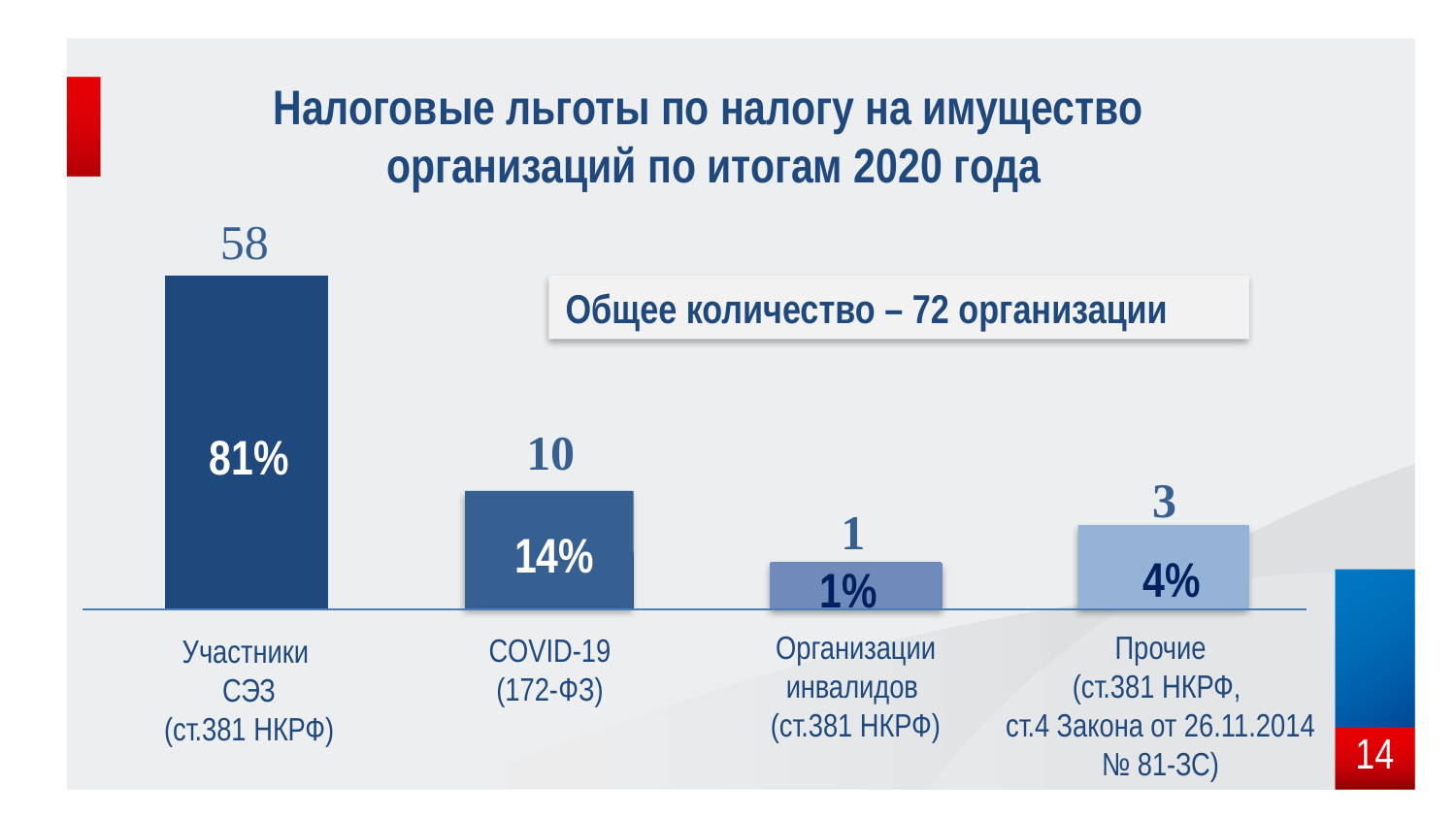
What is the title of the chart on the slide? Налоговые льготы по налогу на имущество организаций по итогам 2020 года Which category has the lowest number of organizations? Организации инвалидов (ст.381 НКРФ) What kind of chart is shown on the slide? Bar chart What percentage is shown on the bar for «Прочие»? 4% Which category has the highest number of organizations? Участники СЭЗ (ст.381 НКРФ) What is the total number of organizations stated on the slide? 72 организации What percentage is shown on the bar for «COVID-19 (172-ФЗ)»? 14% How many organizations are shown for the category «Участники СЭЗ (ст.381 НКРФ)»? 58 How many categories are shown in the chart? 4 How many organizations are shown for «Организации инвалидов (ст.381 НКРФ)»? 1 Which has more organizations: «Прочие» or «Организации инвалидов»? Прочие What is the difference between the number of organizations for «Участники СЭЗ» and for «COVID-19 (172-ФЗ)»? 48